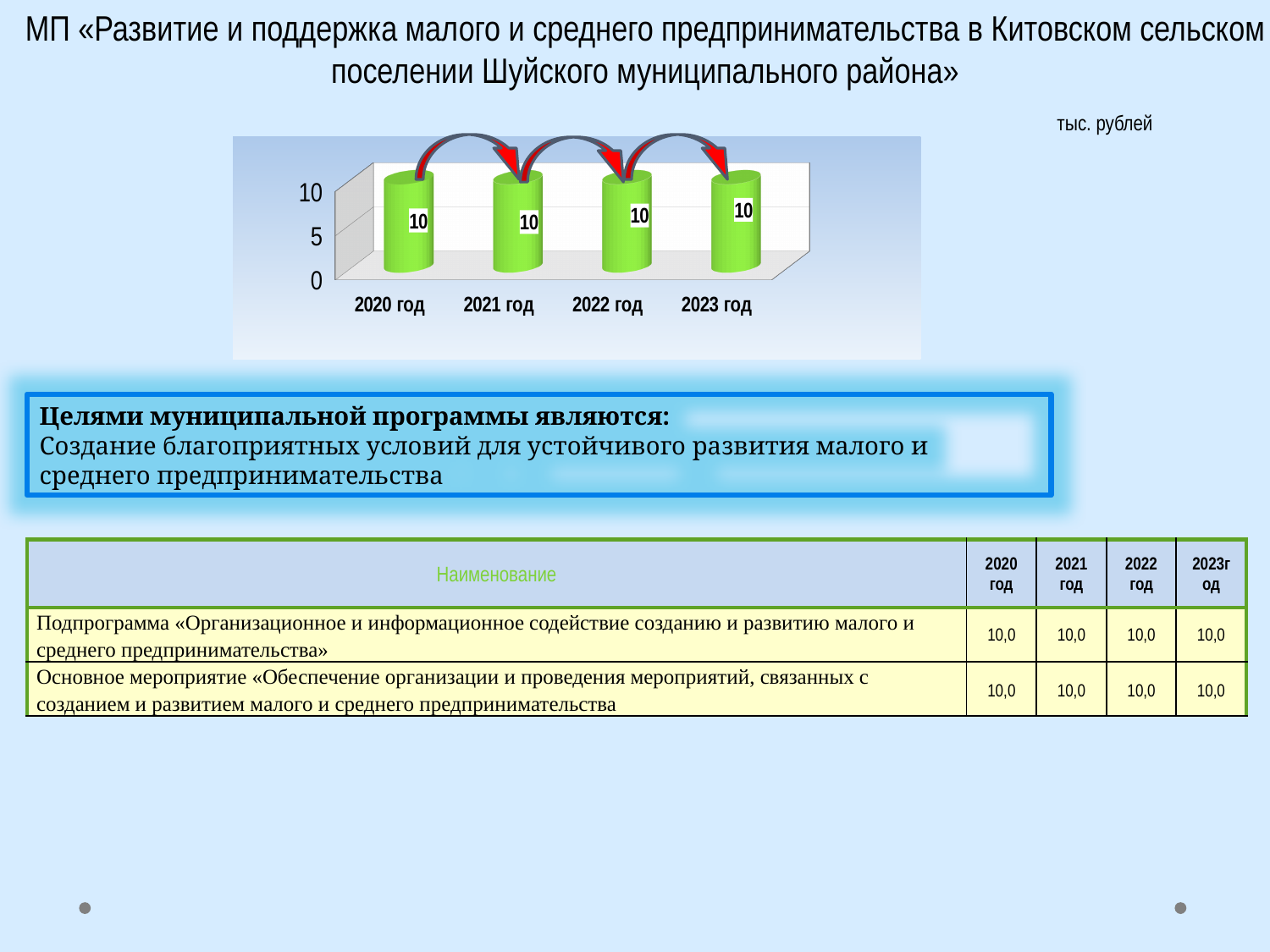
What is the difference between the values for 2023 год and 2020 год? 0 What is the value for 2022 год on the chart? 10 What is the value for 2020 год on the chart? 10 What unit of measurement is indicated for the chart? тыс. рублей How many categories (years) are shown on the chart? 4 What kind of chart is shown on the slide? Bar chart What is the value for 2023 год on the chart? 10 What colour are the bars on the chart? Green What is the value for 2021 год on the chart? 10 Are the values for 2020 год and 2023 год equal? Yes, both are 10 Do the values rise, fall or stay the same from 2020 год to 2023 год? Stay the same Is the value for 2022 год greater or less than 5? greater